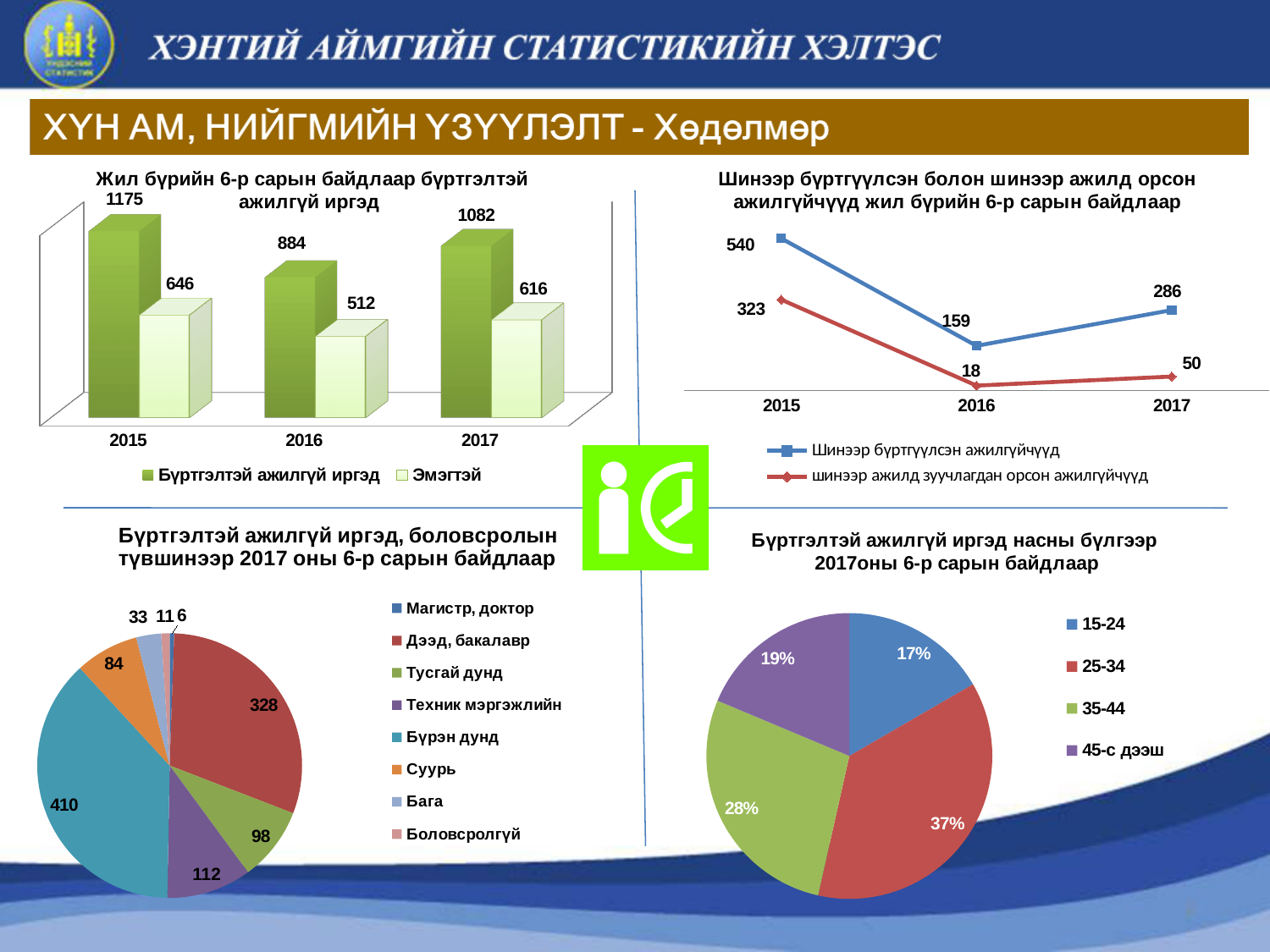
In the top-right line chart, does Шинээр бүртгүүлсэн ажилгүйчүүд rise or fall from 2015 to 2016? fall In the top-left bar chart, what is the value of Эмэгтэй for 2016? 512 In the bottom-left pie chart (education level), what is the value for Бүрэн дунд? 410 In the top-left bar chart, what is the value of Бүртгэлтэй ажилгүй иргэд for 2015? 1175 In the top-right line chart, what is the value of шинээр ажилд зуучлагдан орсон ажилгүйчүүд in 2017? 50 In the top-left bar chart, which year has the lowest value for Бүртгэлтэй ажилгүй иргэд? 2016 In the top-right line chart, how many series does the legend list? 2 In the bottom-right pie chart (age groups), what share does the 25-34 group have? 37% In the top-left bar chart, what is the difference between Бүртгэлтэй ажилгүй иргэд and Эмэгтэй in 2017? 466 In the bottom-right pie chart (age groups), how many categories are shown? 4 In the bottom-left pie chart (education level), which category has the smallest value? Магистр, доктор In the top-right line chart, what is the value of Шинээр бүртгүүлсэн ажилгүйчүүд in 2016? 159